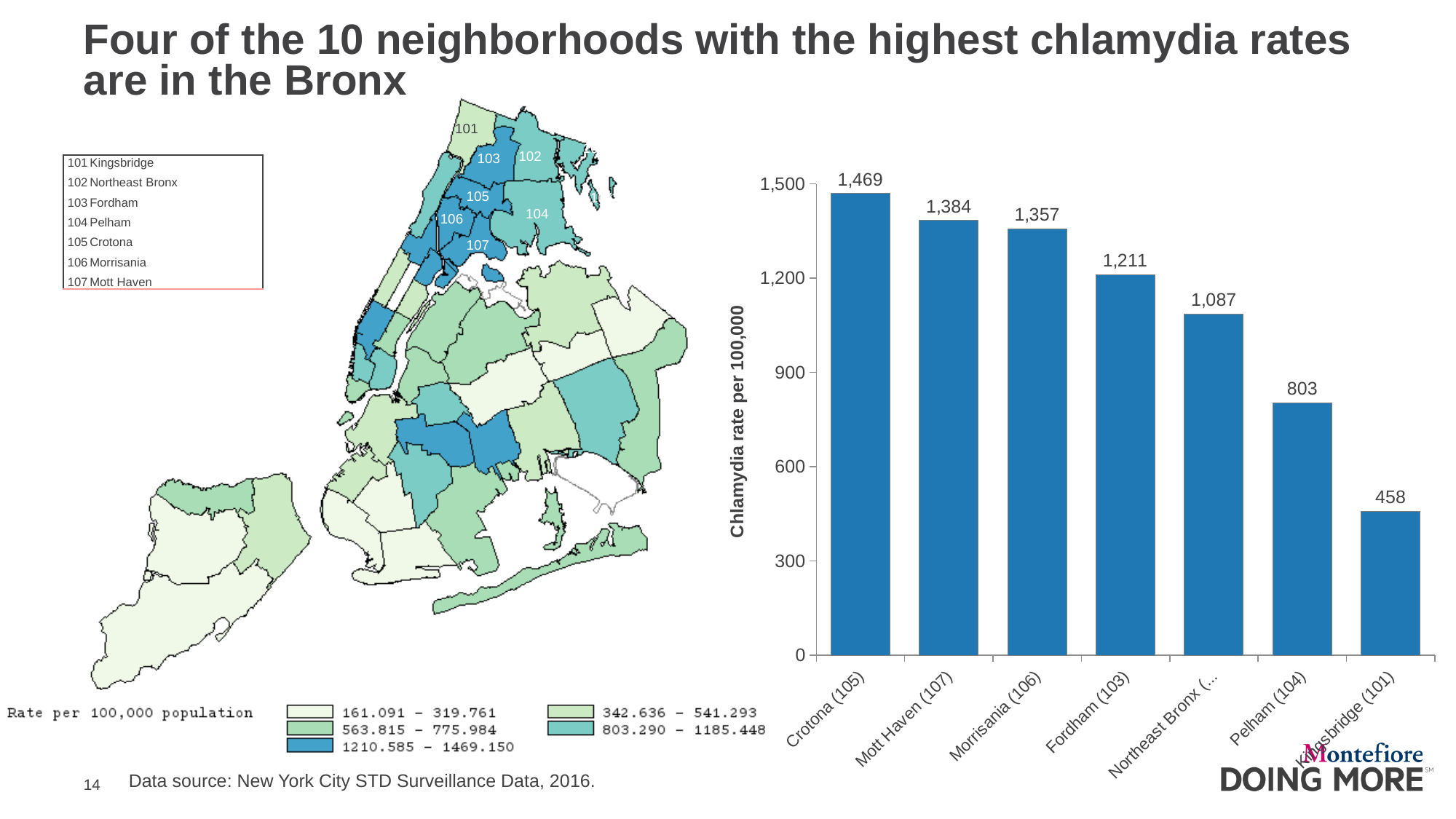
What is the difference between the chlamydia rates of Mott Haven (107) and Morrisania (106)? 27 What is the chlamydia rate per 100,000 for Fordham (103)? 1,211 Which neighborhood has the lowest chlamydia rate in the bar chart? Kingsbridge (101) Is the chlamydia rate for Northeast Bronx greater or less than 900? greater What is the chlamydia rate per 100,000 for Crotona (105)? 1,469 What is the difference between the chlamydia rates of Crotona (105) and Kingsbridge (101)? 1,011 What type of chart is used to show the chlamydia rates by neighborhood? Bar chart Which neighborhood has the highest chlamydia rate in the bar chart? Crotona (105) Which has a higher chlamydia rate, Fordham (103) or Pelham (104)? Fordham (103) How many neighborhoods are shown in the bar chart? 7 Do the chlamydia rates rise or fall from left to right across the bar chart? Fall What is the chlamydia rate per 100,000 for Pelham (104)? 803